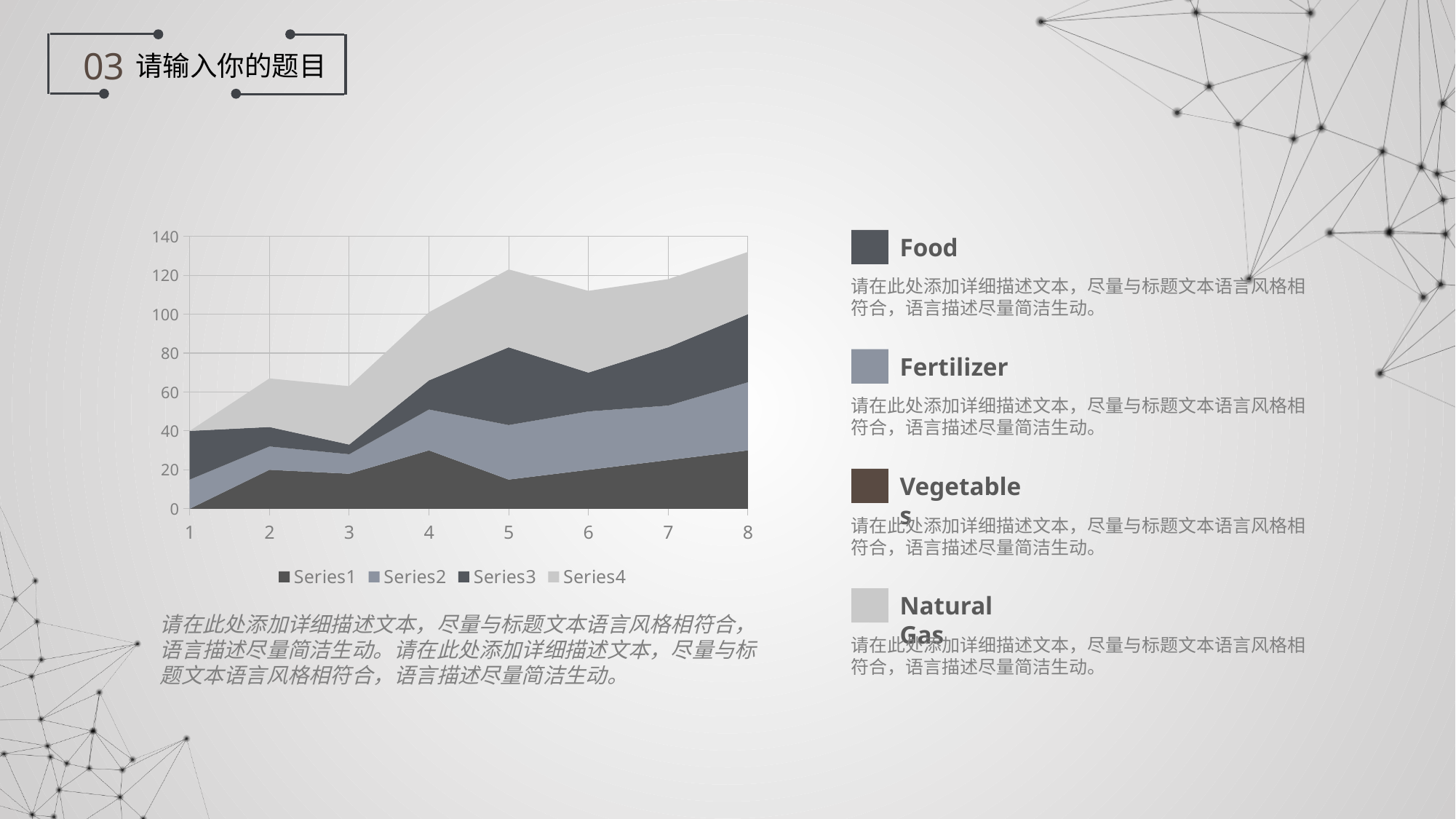
How many series does the chart's legend list? 4 Does the stacked total generally rise or fall from x = 1 to x = 8? rise Is the stacked total at x = 8 greater or less than 120? greater Is the stacked total at x = 6 greater or less than 100? greater Is the stacked total at x = 1 greater or less than 60? less What are the series names listed in the chart's legend? Series1, Series2, Series3, Series4 What is the highest value shown on the chart's y axis? 140 At which x-axis point is the stacked total lowest? 1 What kind of chart is shown on the slide? Stacked area chart How many points are plotted along the x axis of the chart? 8